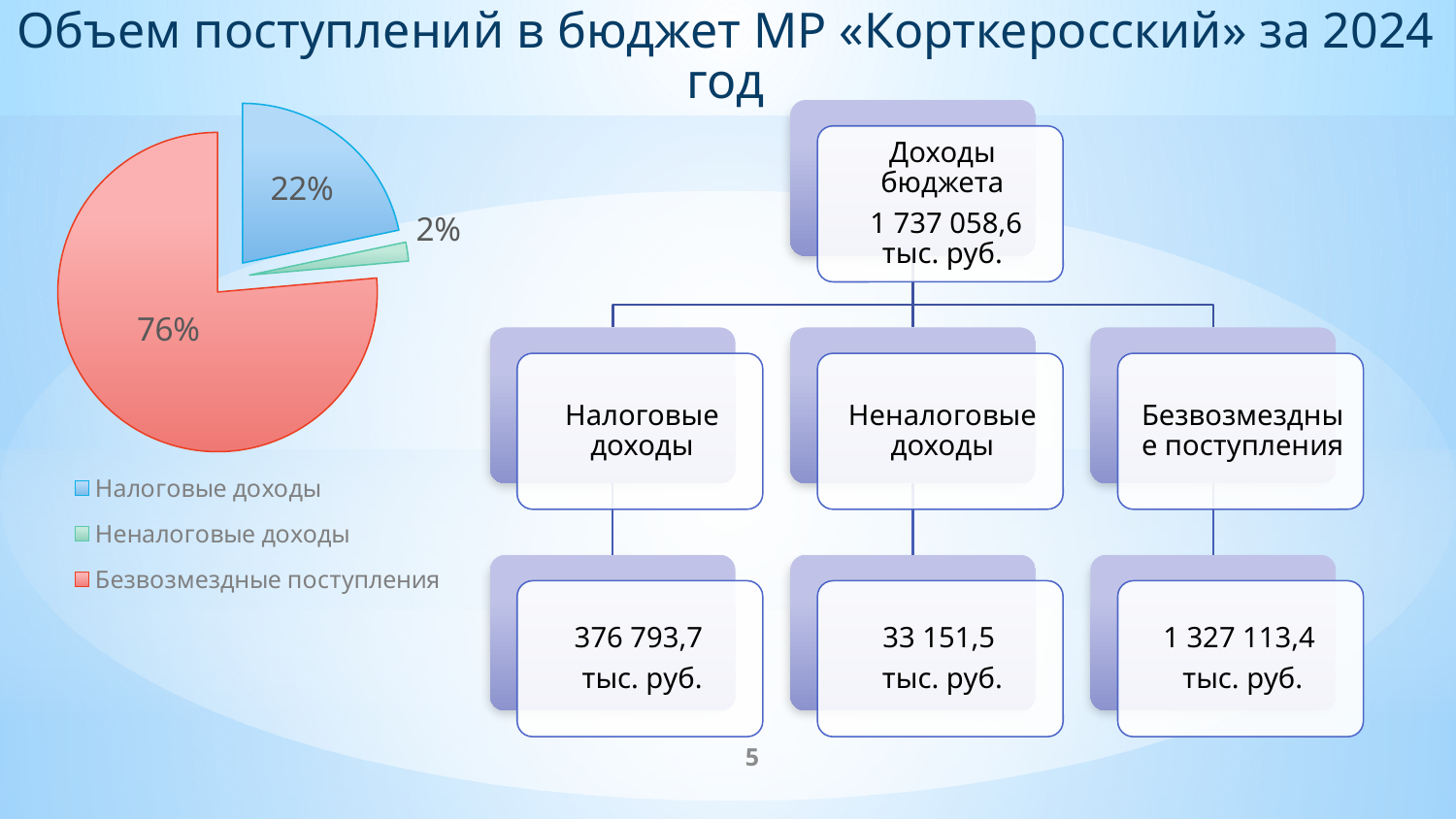
Which category has the largest slice in the pie chart? Безвозмездные поступления What colour is the Налоговые доходы slice in the pie chart? Blue What colour is the Безвозмездные поступления slice in the pie chart? Red By how many percentage points does the Безвозмездные поступления slice exceed the Налоговые доходы slice? 54 percentage points What share of the pie chart is labelled Безвозмездные поступления? 76% How many slices does the pie chart have? 3 What share of the pie chart is labelled Неналоговые доходы? 2% What type of chart is shown on the left of the slide? Pie chart Which category has the smallest slice in the pie chart? Неналоговые доходы Which slice is larger in the pie chart: Налоговые доходы or Неналоговые доходы? Налоговые доходы How many entries does the pie chart legend list? 3 What share of the pie chart is labelled Налоговые доходы? 22%